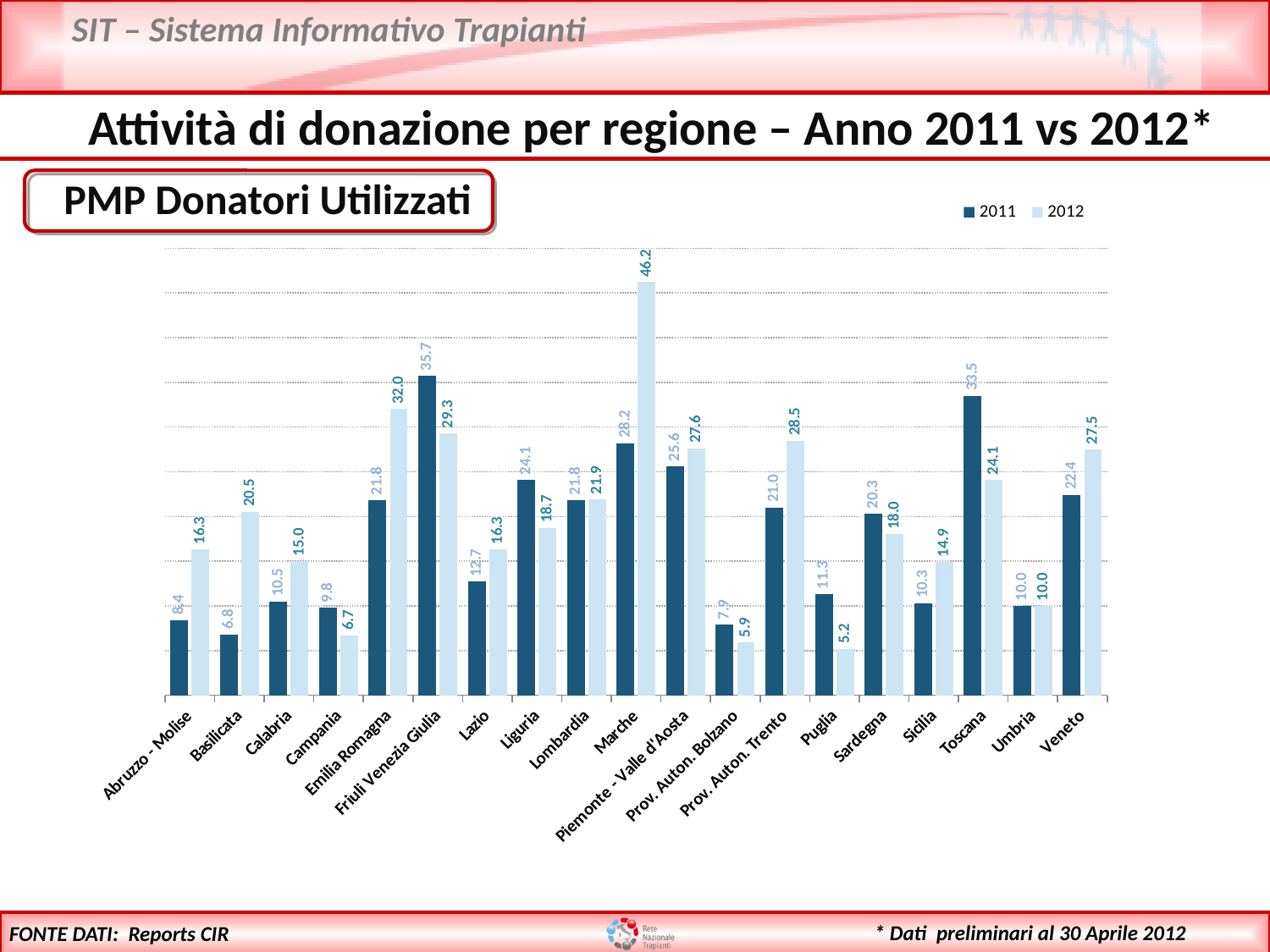
What is the 2012 value for Marche? 46.2 Which is larger for Toscana, the 2011 value or the 2012 value? 2011 What is the difference between the 2012 and 2011 values for Emilia Romagna? 10.2 What kind of chart is shown? Bar chart Which region has the highest 2012 value? Marche Which region has the lowest 2011 value? Basilicata What is the 2011 value for Friuli Venezia Giulia? 35.7 What is the 2012 value for Prov. Auton. Trento? 28.5 How many regions are shown on the x axis? 19 What is the title shown in the box above the chart? PMP Donatori Utilizzati How many series does the legend list? 2 Which region has the lowest 2012 value? Puglia